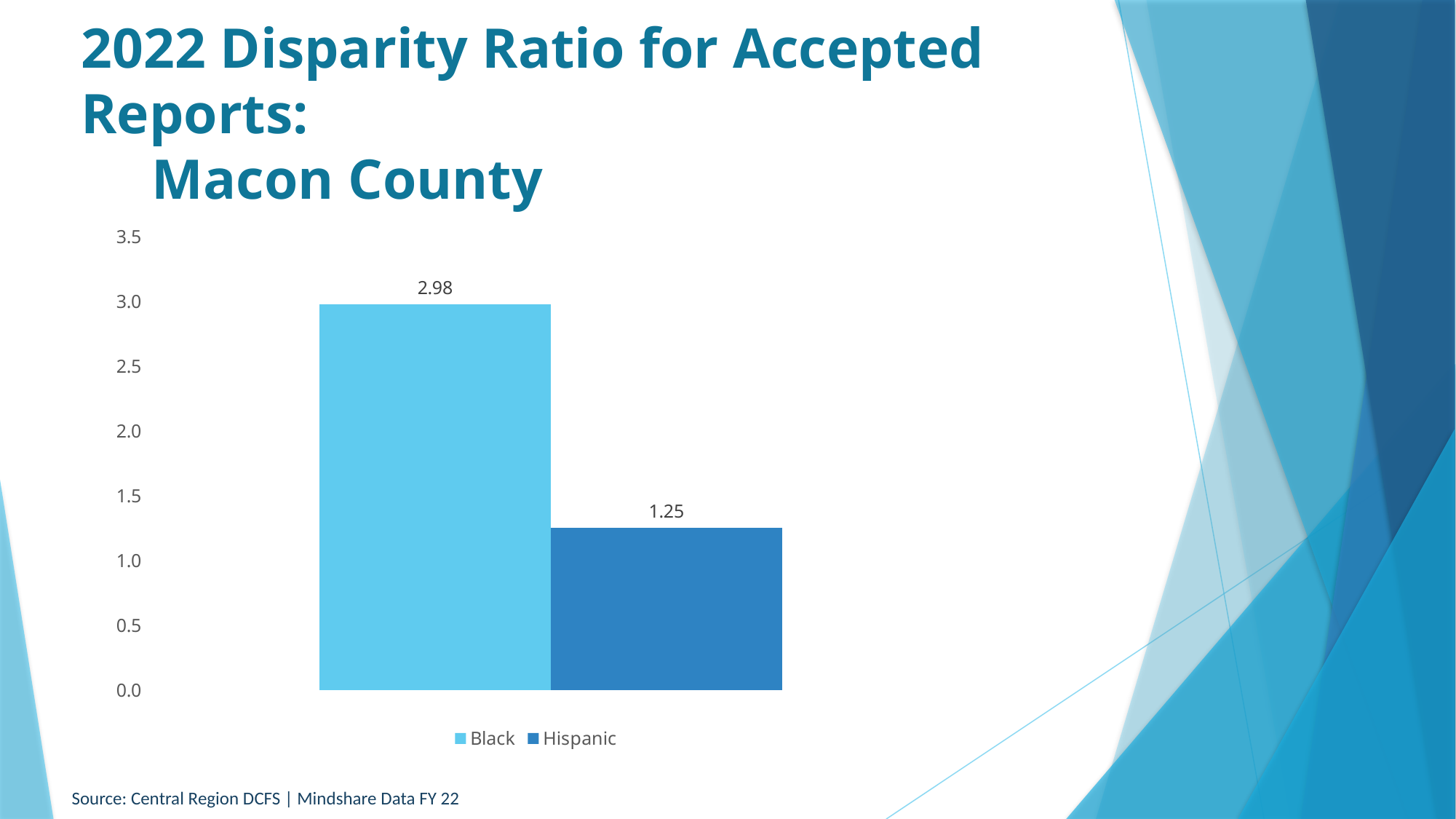
Is the value for Hispanic greater or less than 1.5? less What is the disparity ratio for Black? 2.98 How many bars are plotted in the chart? 2 How many series does the legend list? 2 Is the disparity ratio for Black larger or smaller than the ratio for Hispanic? larger Which group has the lower disparity ratio? Hispanic Which group has the higher disparity ratio? Black Is the value for Black greater or less than 2.5? greater What kind of chart is shown on the slide? bar chart What is the disparity ratio for Hispanic? 1.25 What is the difference between the Black and Hispanic disparity ratios? 1.73 What is the highest value shown on the vertical axis? 3.5